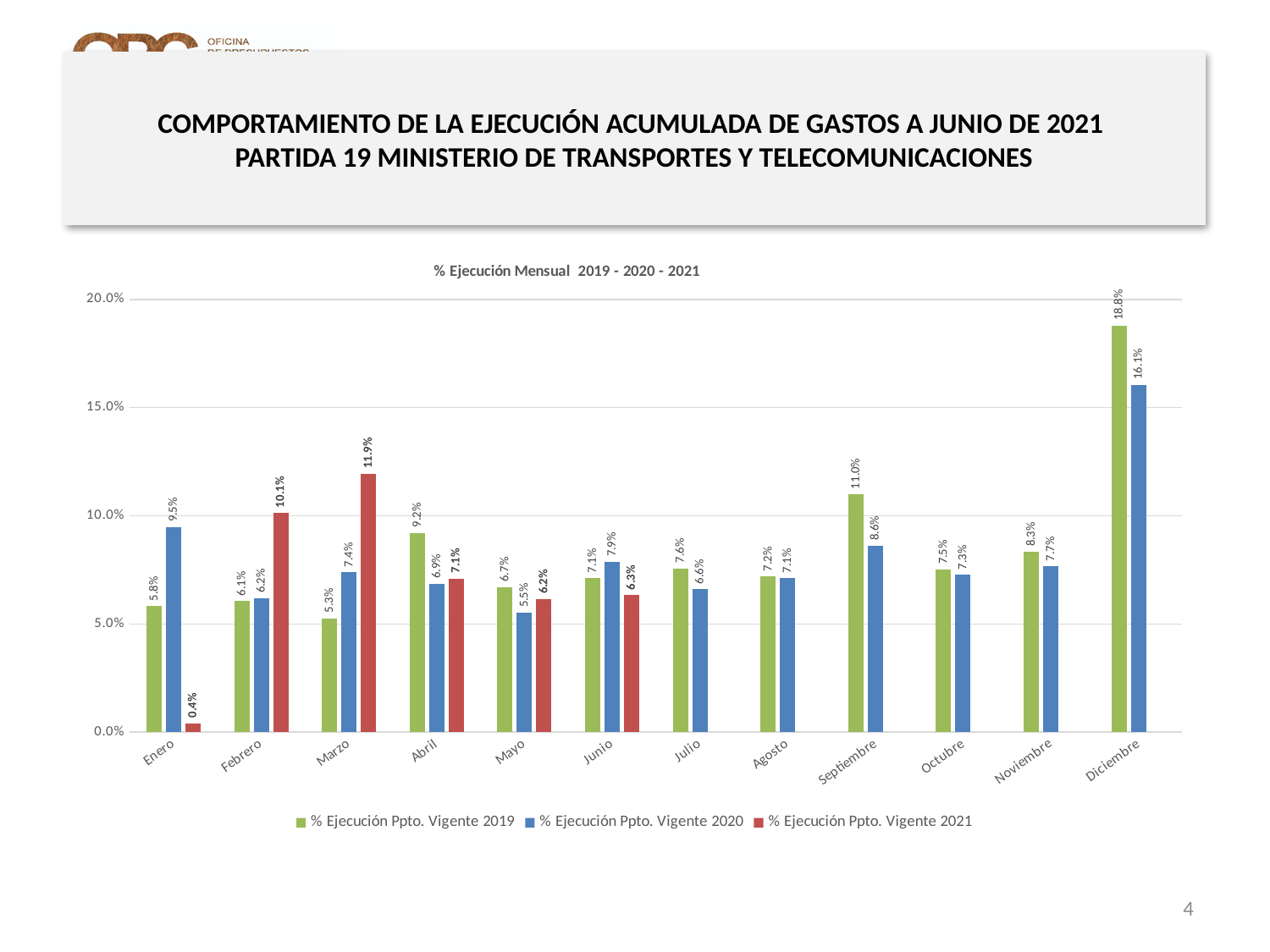
What is the value for % Ejecución Ppto. Vigente 2020 in Enero? 9.5% In Abril, which is larger: the 2019 value or the 2020 value? 2019 value What type of chart is shown on the slide? Bar chart What is the value for % Ejecución Ppto. Vigente 2019 in Septiembre? 11.0% Is the value for % Ejecución Ppto. Vigente 2021 in Febrero greater or less than 10.0%? greater What is the title of the chart? % Ejecución Mensual 2019 - 2020 - 2021 What is the difference between the 2019 and 2020 values in Diciembre? 2.7% How many months are shown on the x axis? 12 Which month has the lowest value for % Ejecución Ppto. Vigente 2021? Enero Which month has the highest value for % Ejecución Ppto. Vigente 2019? Diciembre What is the value for % Ejecución Ppto. Vigente 2021 in Marzo? 11.9% How many series does the legend list? 3